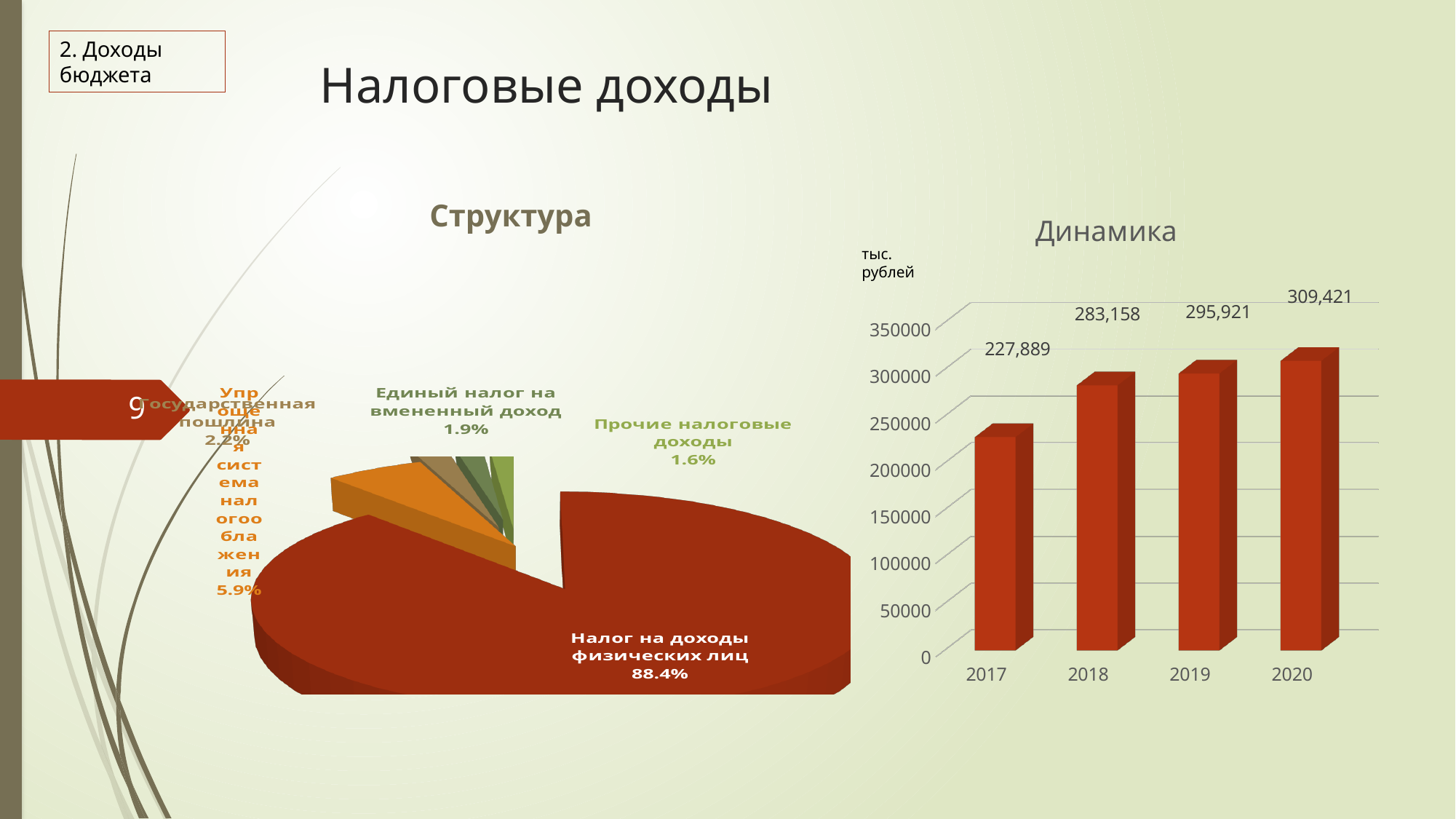
How many years are shown in the 'Динамика' chart? 4 In the 'Динамика' chart, what is the value for 2020? 309,421 What kind of chart is the 'Динамика' chart? bar chart In the 'Динамика' chart, which year has the highest value? 2020 In the 'Динамика' chart, do the values rise or fall from 2017 to 2020? rise What kind of chart is the 'Структура' chart? pie chart In the 'Структура' chart, which is larger: 'Государственная пошлина' or 'Прочие налоговые доходы'? Государственная пошлина In the 'Структура' chart, what share does 'Налог на доходы физических лиц' have? 88.4% In the 'Динамика' chart, what is the difference between the 2019 and 2018 values? 12,763 In the 'Динамика' chart, what is the value for 2017? 227,889 In the 'Структура' chart, what share does 'Единый налог на вмененный доход' have? 1.9% In the 'Динамика' chart, which year has the lowest value? 2017